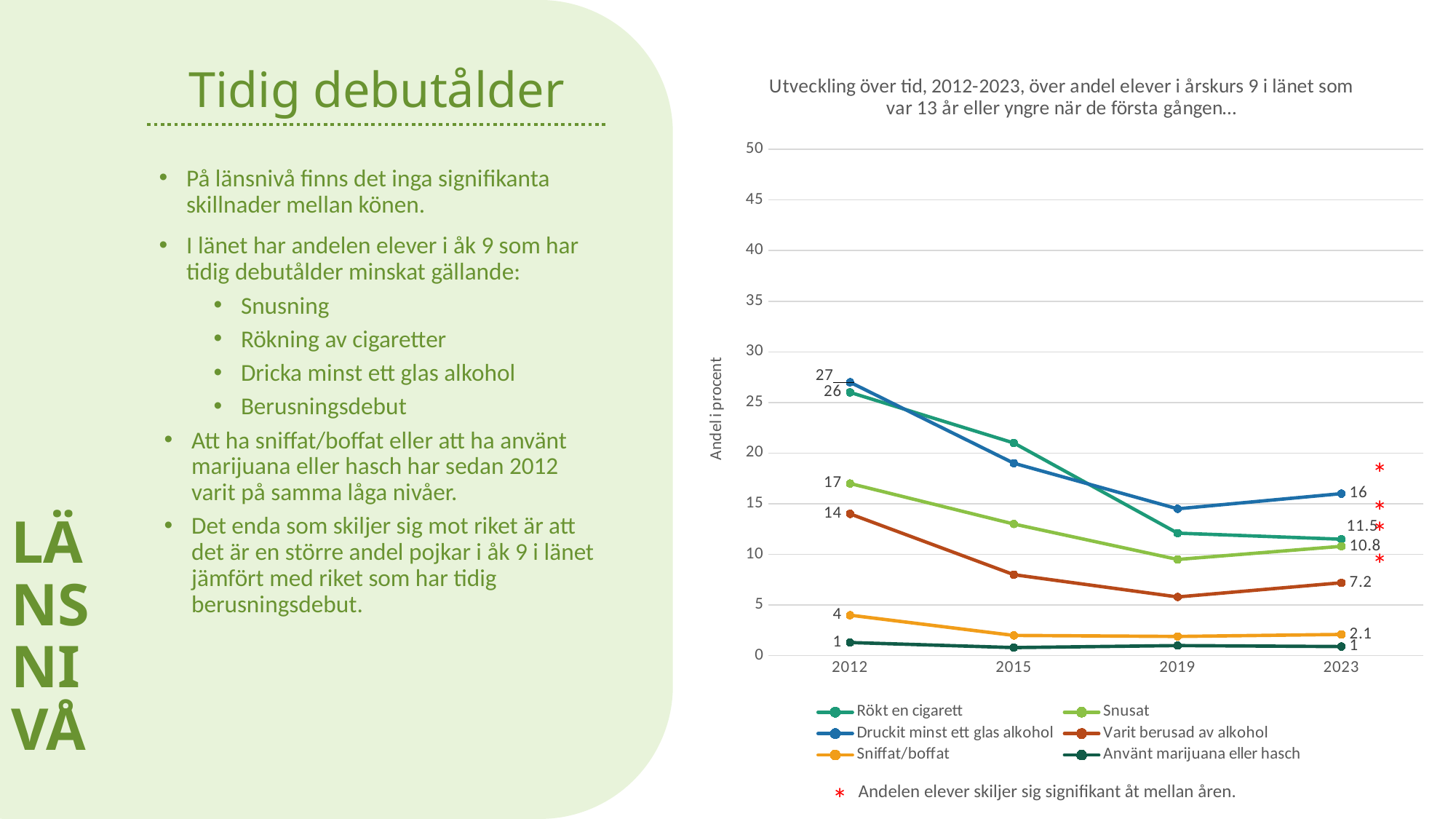
What is the value for 'Varit berusad av alkohol' in 2023? 7.2 Is the value for 'Snusat' in 2015 greater or less than 15? less What is the value for 'Druckit minst ett glas alkohol' in 2012? 27 What is the value for 'Sniffat/boffat' in 2023? 2.1 What is the value for 'Snusat' in 2023? 10.8 By how much did the value for 'Druckit minst ett glas alkohol' fall from 2012 to 2023? 11 How many series does the chart's legend list? 6 How many years are plotted along the x axis of the chart? 4 What is the title of the y axis? Andel i procent Which series has the highest value in 2012? Druckit minst ett glas alkohol What is the value for 'Rökt en cigarett' in 2012? 26 What kind of chart is shown on the slide? Line chart